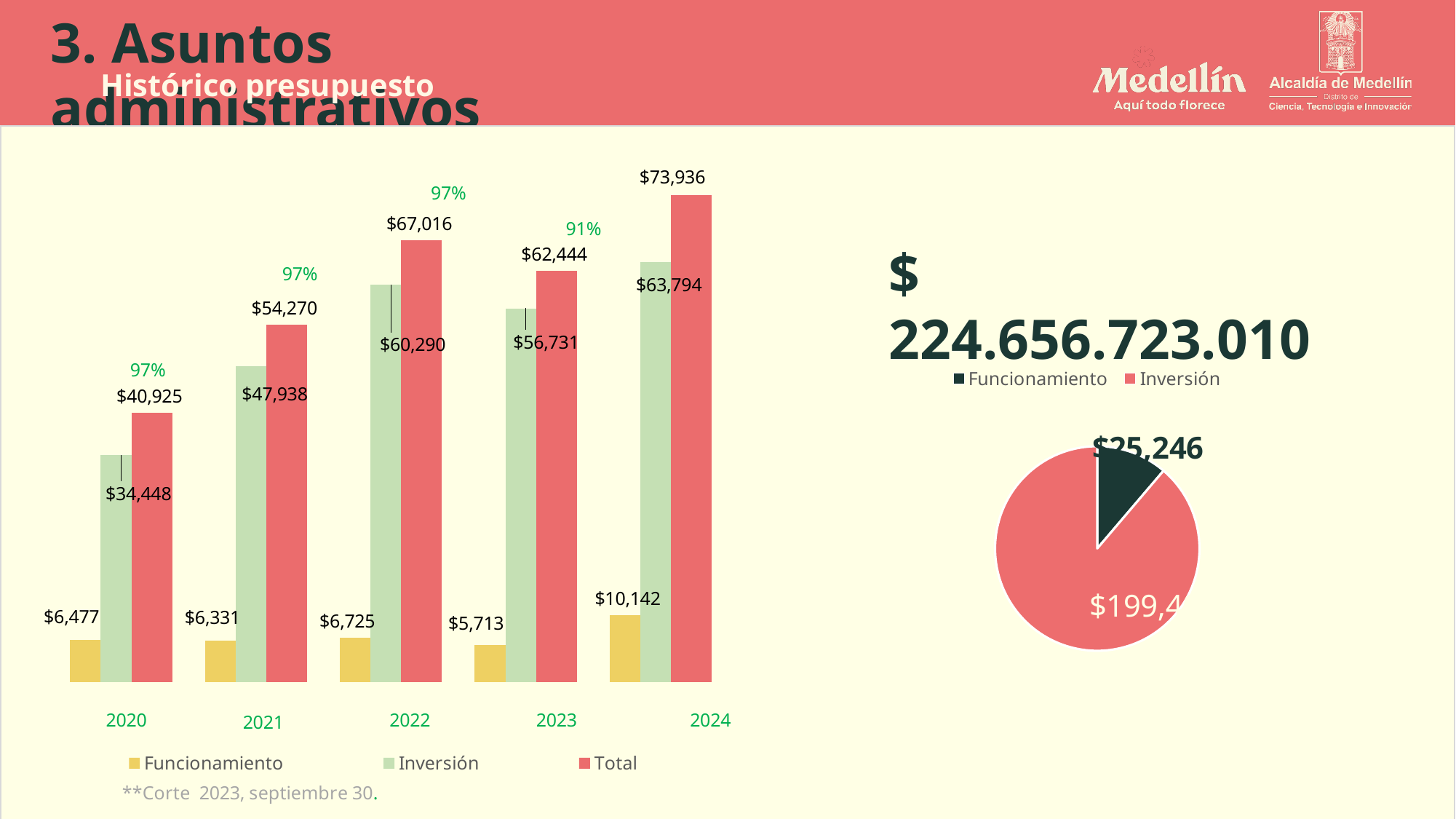
In the bar chart, does the Total rise or fall from 2020 to 2022? Rises What kind of chart is the chart on the left of the slide? Bar chart In the bar chart, is the Inversión value larger in 2022 or in 2023? 2022 How many series does the legend of the bar chart list? 3 In the bar chart, what is the difference between the Total for 2024 and the Total for 2023? $11,492 In the bar chart, what is the Inversión value for 2021? $47,938 In the bar chart, what is the Funcionamiento value for 2023? $5,713 How many years are shown on the x axis of the bar chart? 5 In the bar chart, which year has the lowest Funcionamiento value? 2023 In the bar chart, what is the Total value for 2024? $73,936 In the pie chart on the right, what is the value of the Funcionamiento slice? $25,246 In the bar chart, which year has the highest Total? 2024